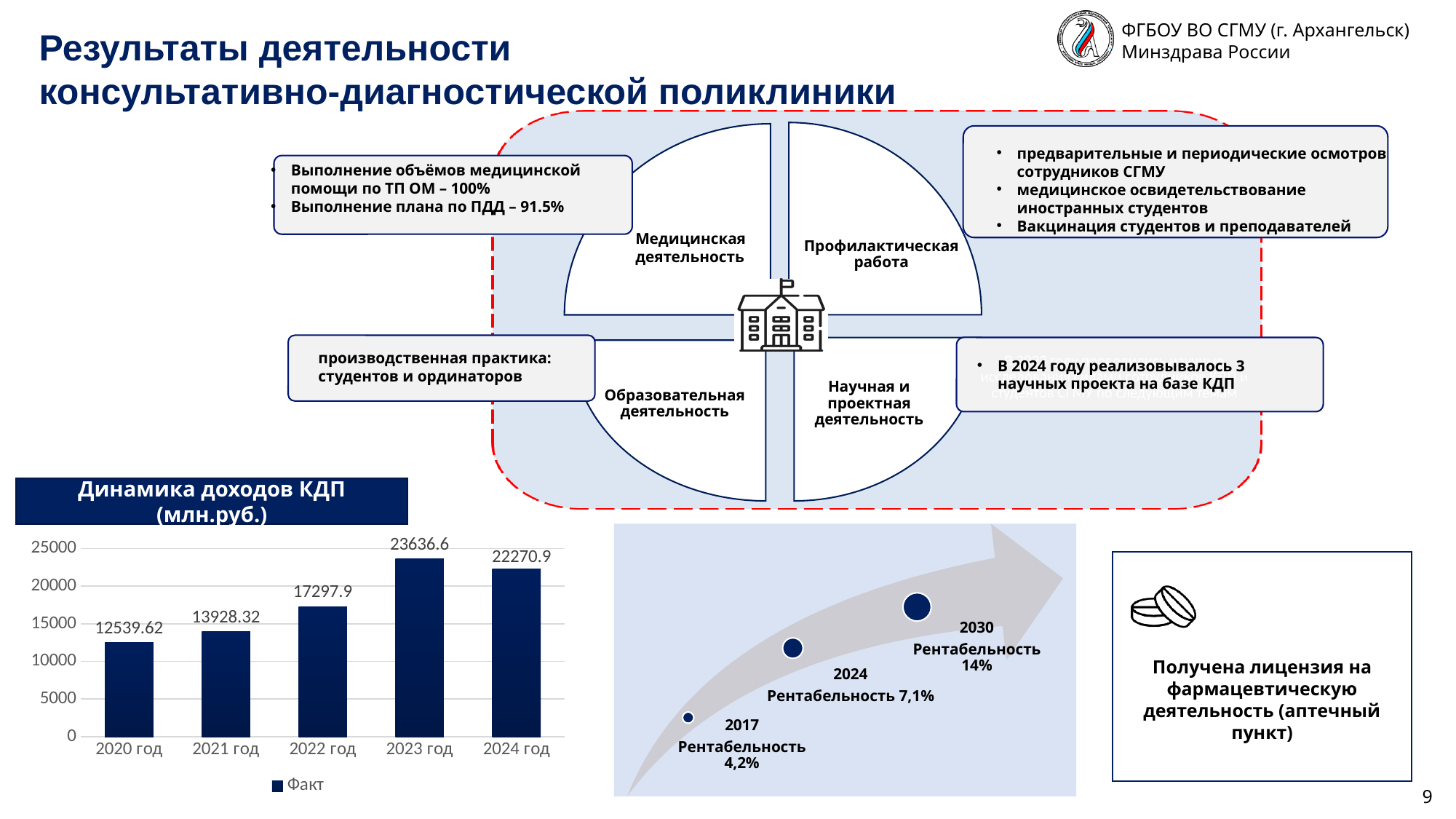
Which is larger in the chart 'Динамика доходов КДП (млн.руб.)': the value for 2021 год or 2022 год? 2022 год What kind of chart is 'Динамика доходов КДП (млн.руб.)'? bar chart What is the value for 2024 год in the chart 'Динамика доходов КДП (млн.руб.)'? 22270.9 Which year has the highest value in the chart 'Динамика доходов КДП (млн.руб.)'? 2023 год Which year has the lowest value in the chart 'Динамика доходов КДП (млн.руб.)'? 2020 год What is the difference between the values for 2023 год and 2024 год in the chart 'Динамика доходов КДП (млн.руб.)'? 1365.7 How many series does the legend of the chart 'Динамика доходов КДП (млн.руб.)' list? 1 How many years are shown on the x axis of the chart 'Динамика доходов КДП (млн.руб.)'? 5 What is the value for 2023 год in the chart 'Динамика доходов КДП (млн.руб.)'? 23636.6 What is the legend entry of the chart 'Динамика доходов КДП (млн.руб.)'? Факт Is the value for 2022 год in the chart 'Динамика доходов КДП (млн.руб.)' greater or less than 15000? greater What is the value for 2020 год in the chart 'Динамика доходов КДП (млн.руб.)'? 12539.62